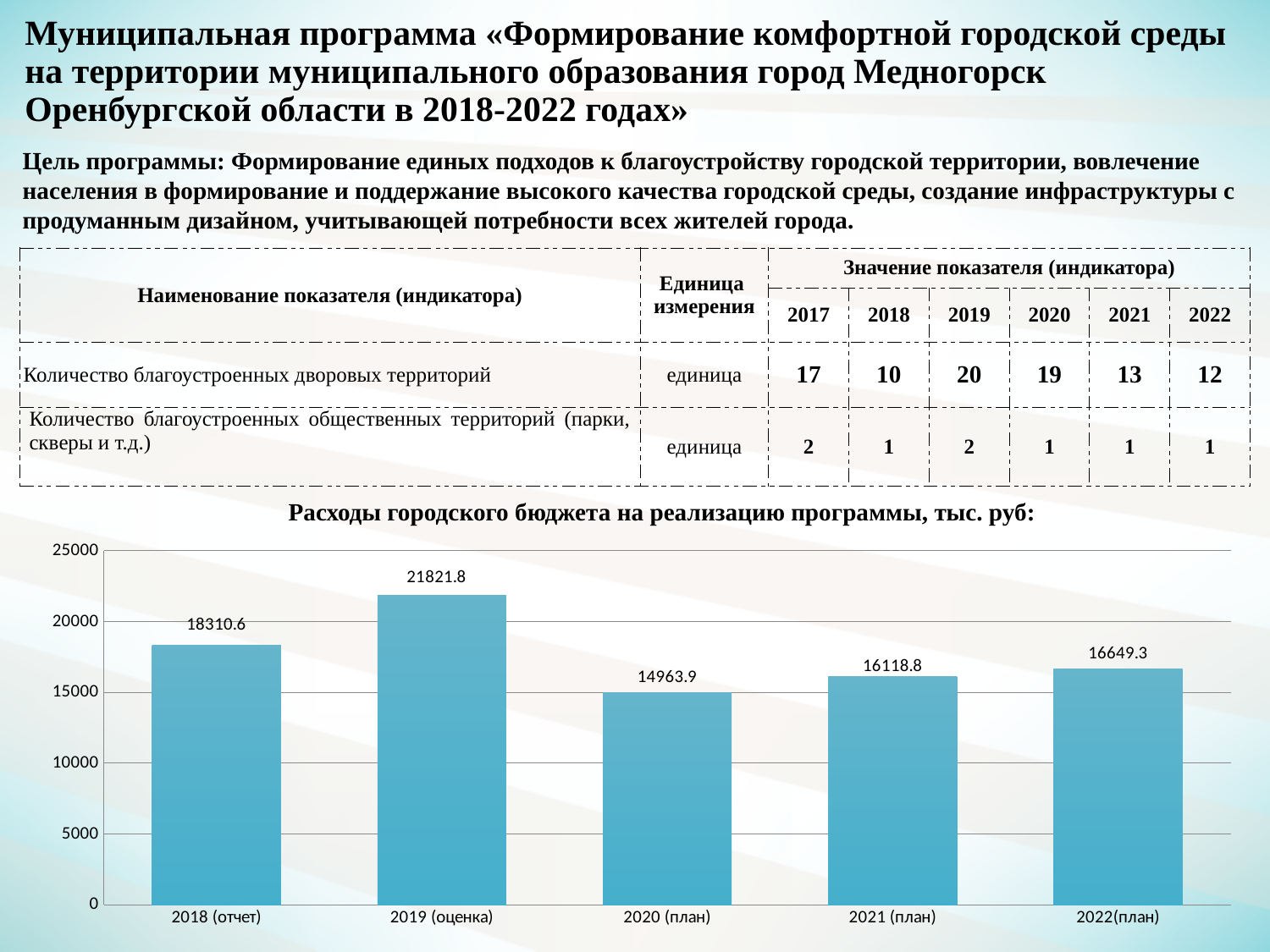
What is the difference between the values for 2022(план) and 2021 (план)? 530.5 What is the value for 2022(план) in the chart? 16649.3 Which is larger, the value for 2021 (план) or the value for 2022(план)? 2022(план) What is the difference between the values for 2019 (оценка) and 2018 (отчет)? 3511.2 Which category has the highest value in the chart? 2019 (оценка) What is the value for 2018 (отчет) in the chart? 18310.6 What is the value for 2020 (план) in the chart? 14963.9 What is the title of the chart? Расходы городского бюджета на реализацию программы, тыс. руб: How many categories are shown on the x axis of the chart? 5 What kind of chart is shown on the slide? bar chart Which category has the lowest value in the chart? 2020 (план) Is the value for 2019 (оценка) greater or less than 20000? greater